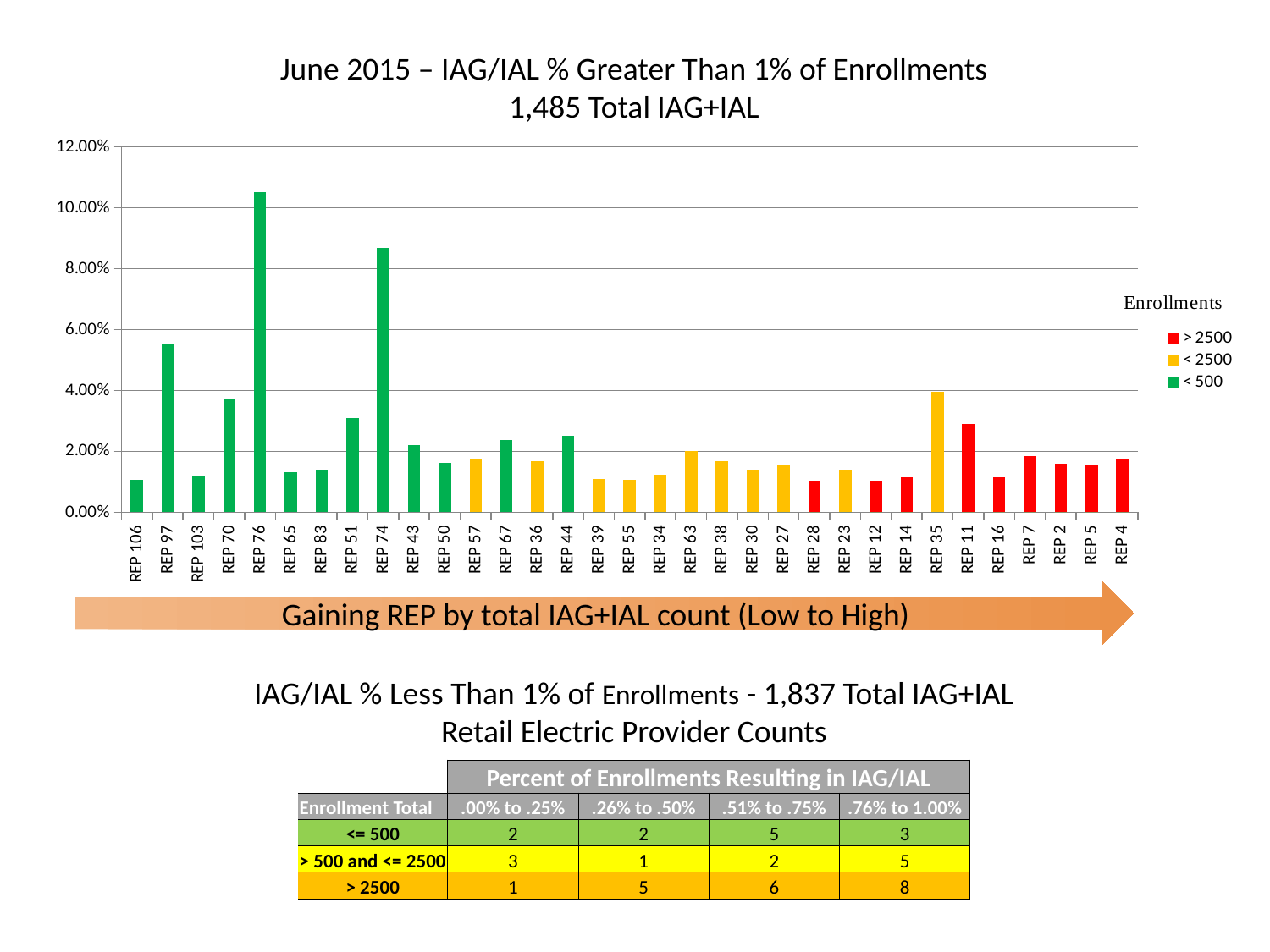
Is the value for REP 97 greater or less than 4.00%? greater Is the value for REP 74 greater or less than 8.00%? greater What is the title of the chart's legend? Enrollments How many REP categories are plotted along the x axis of the chart? 33 Which has a higher value, REP 97 or REP 74? REP 74 Which REP has the highest IAG/IAL percentage in the chart? REP 76 Is the value for REP 106 greater or less than 2.00%? less What colour represents the "> 2500" enrollments series in the chart? red Which has a higher value, REP 76 or REP 74? REP 76 How many series does the chart legend list? 3 What kind of chart is shown on the slide? bar chart